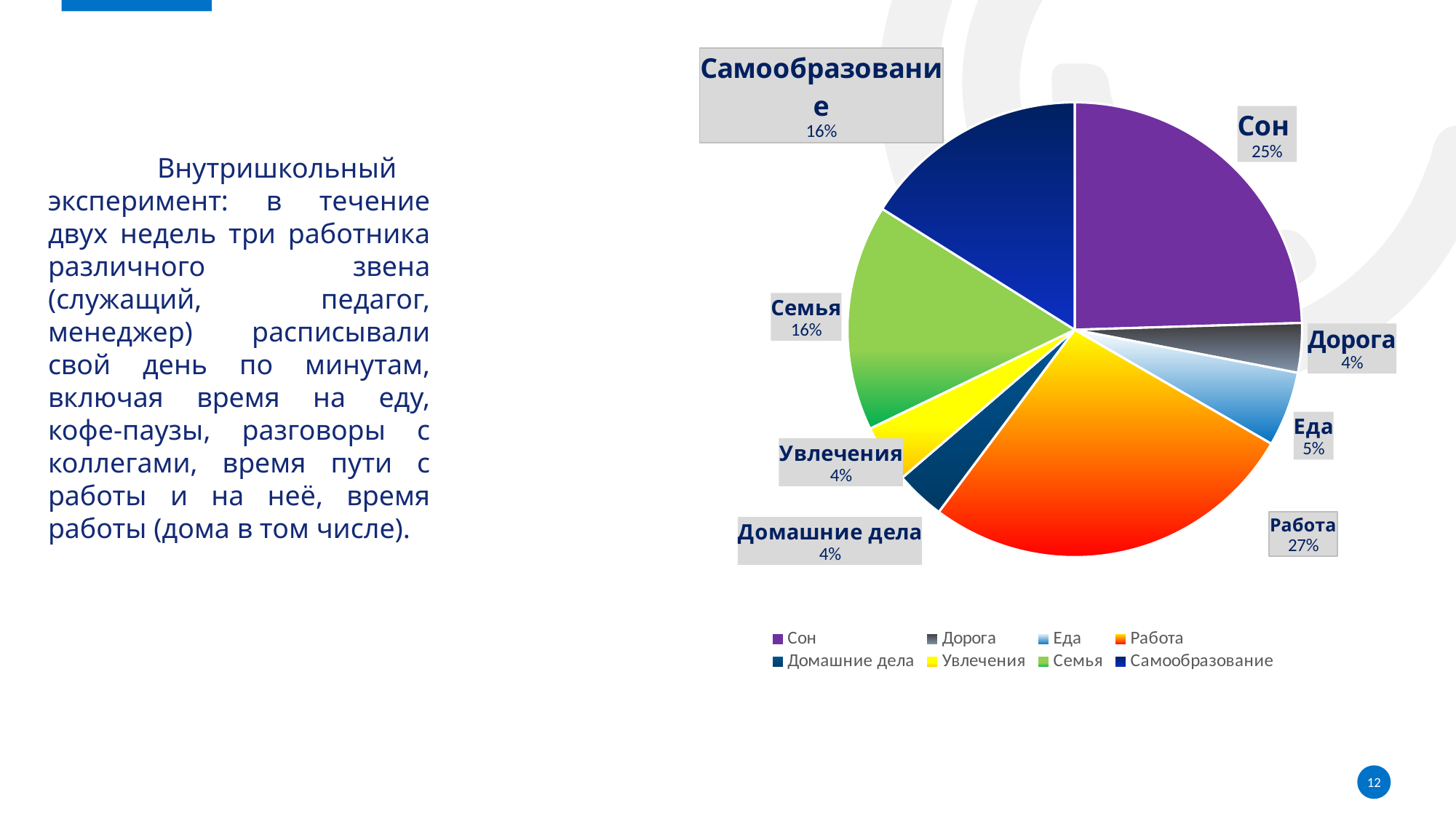
What is the difference between the values for Семья and Дорога? 12% What share of the pie does Сон take? 25% What colour is the slice for Увлечения? yellow What is the difference between the values for Работа and Сон? 2% What is the value shown for Еда? 5% How many categories are shown in the pie chart? 8 What kind of chart is shown on the slide? pie chart What is the value shown for Самообразование? 16% Which is larger, the slice for Сон or the slice for Работа? Работа What is the value shown for Работа? 27% Which category has the largest slice of the pie? Работа What is the value shown for Семья? 16%